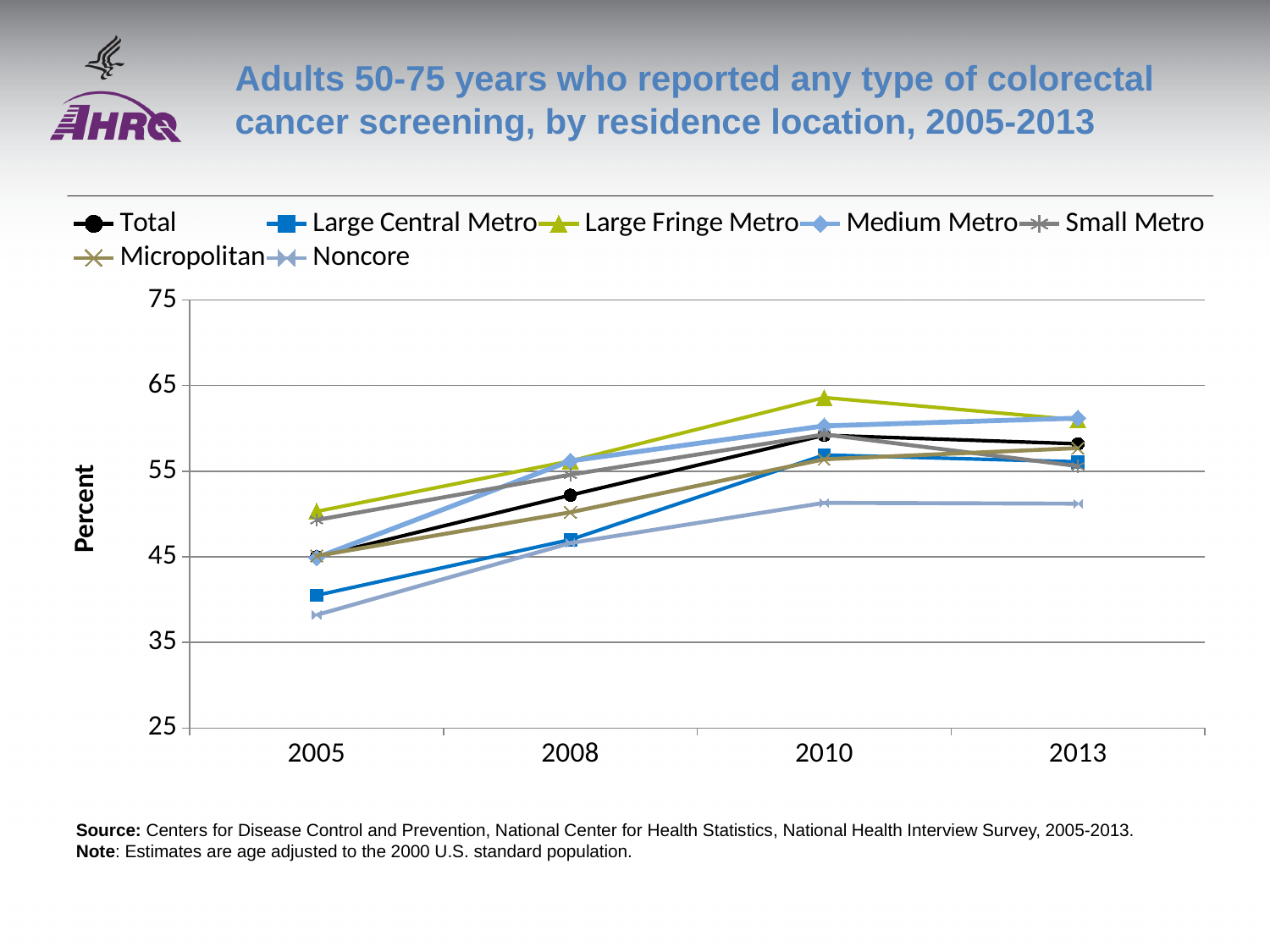
Is the value for Total in 2005 greater or less than 55? less Is the value for Large Central Metro in 2005 greater or less than 45? less Which residence location had the lowest value in 2013? Noncore What type of chart is shown on the slide? Line chart Does the Total line rise or fall from 2005 to 2010? Rises Is the value for Large Fringe Metro in 2010 greater or less than 55? greater How many series does the legend list? 7 Which residence location had the lowest value in 2005? Noncore How many years are shown on the x axis? 4 In 2008, which is larger: the value for Large Fringe Metro or the value for Noncore? Large Fringe Metro Which residence location had the highest value in 2010? Large Fringe Metro